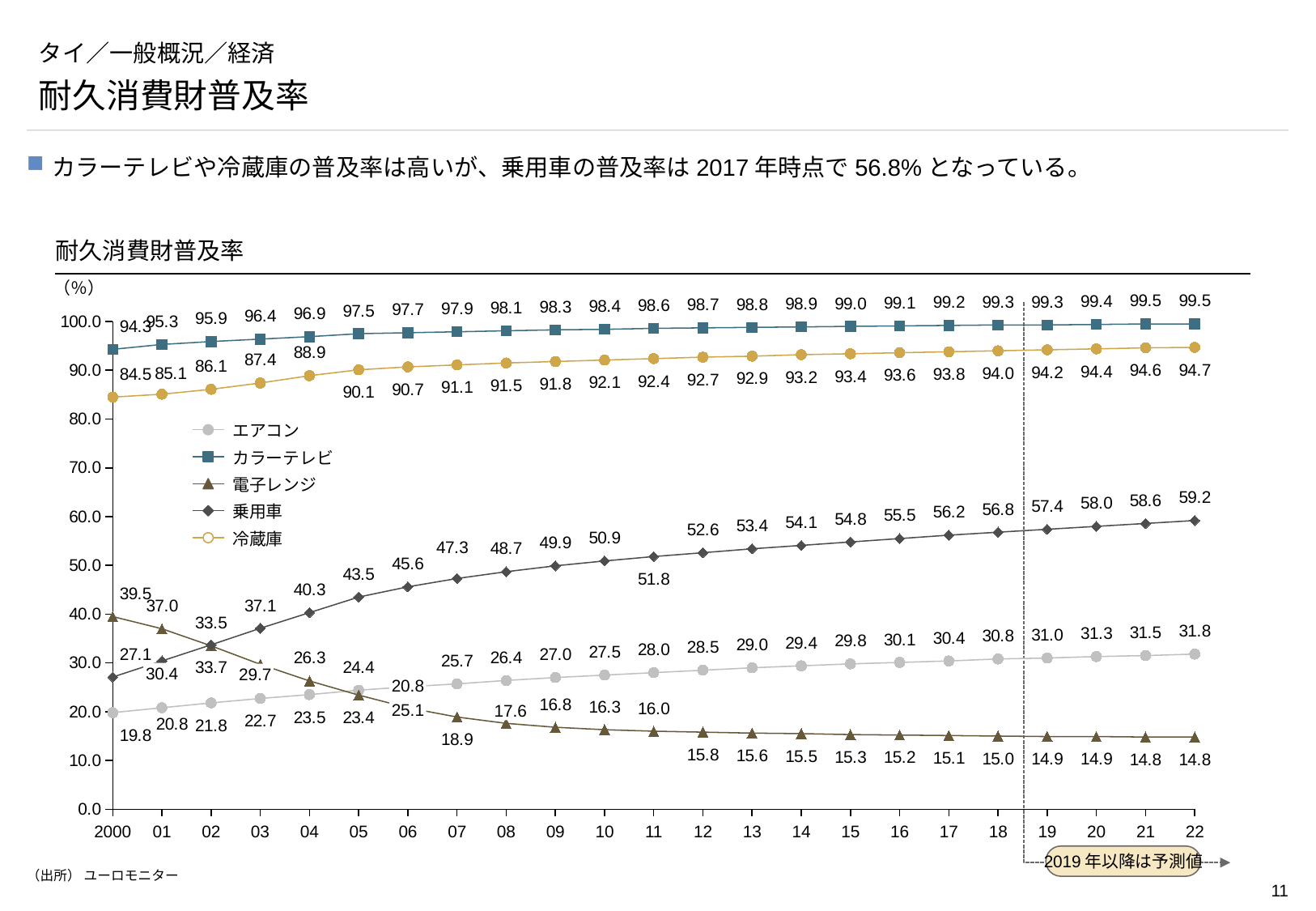
How many series does the legend list? 5 Which is larger in 2010, the value for エアコン or the value for 電子レンジ? エアコン Does the value for 電子レンジ rise or fall from 2000 to 2022? fall What is the difference between the 乗用車 value in 2022 and in 2000? 32.1 How many years are plotted on the x axis? 23 What is the value for 冷蔵庫 in 2022? 94.7 What is the value for カラーテレビ in 2000? 94.3 Which series has the highest value in 2022? カラーテレビ What is the value for 乗用車 in 2017? 56.2 What is the value for 電子レンジ in 2005? 23.4 What type of chart is shown on the slide? line chart Which series has the lowest value in 2022? 電子レンジ